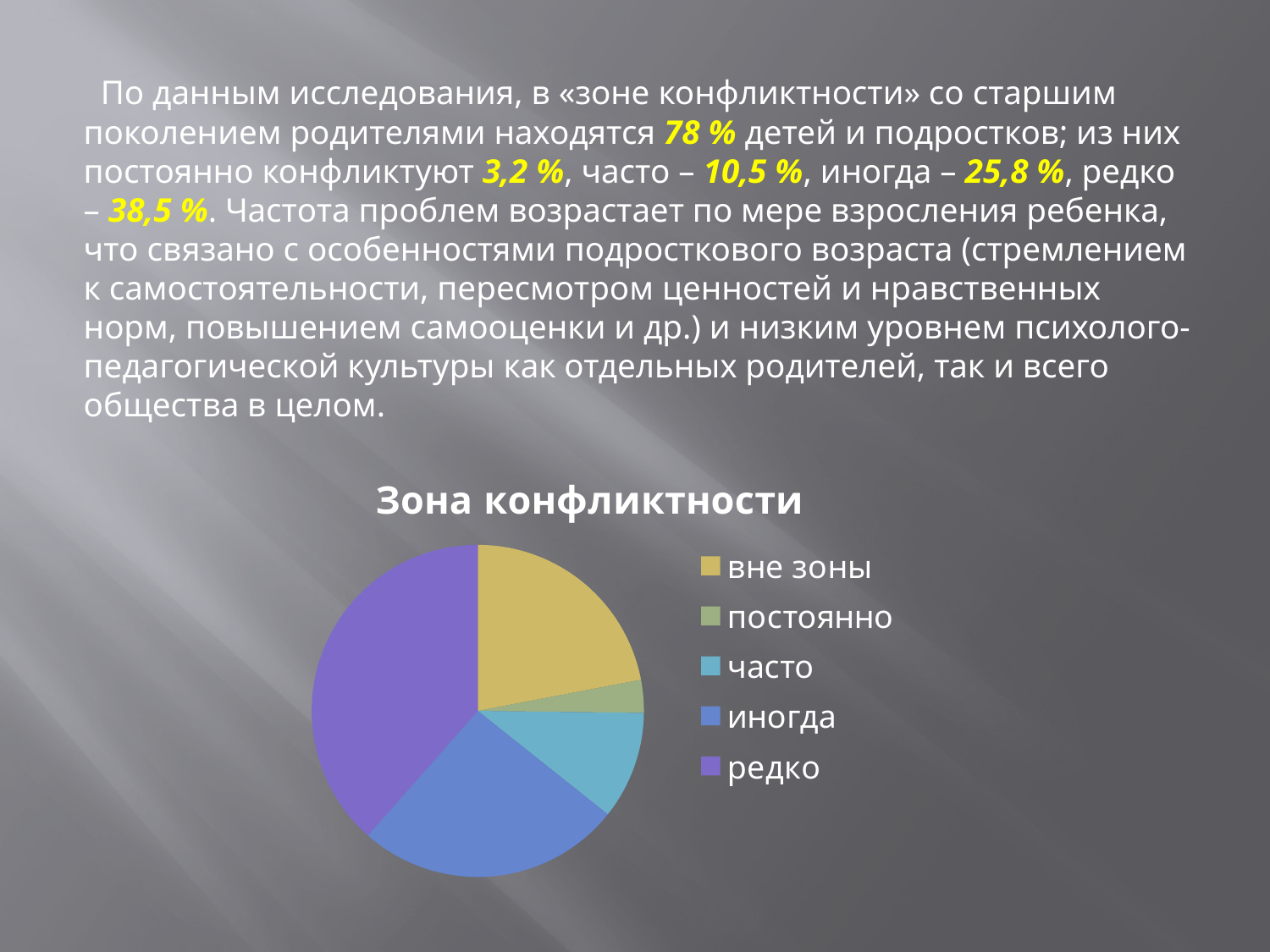
Which slice is larger, редко or иногда? редко What kind of chart is shown on the slide? pie chart Which category has the smallest slice of the pie? постоянно Which category has the largest slice of the pie? редко How many entries does the chart legend list? 5 What is the title of the chart? Зона конфликтности Which slice is larger, иногда or часто? иногда What colour is the slice for редко in the pie chart? purple How many slices does the pie chart have? 5 Which slice is larger, вне зоны or постоянно? вне зоны